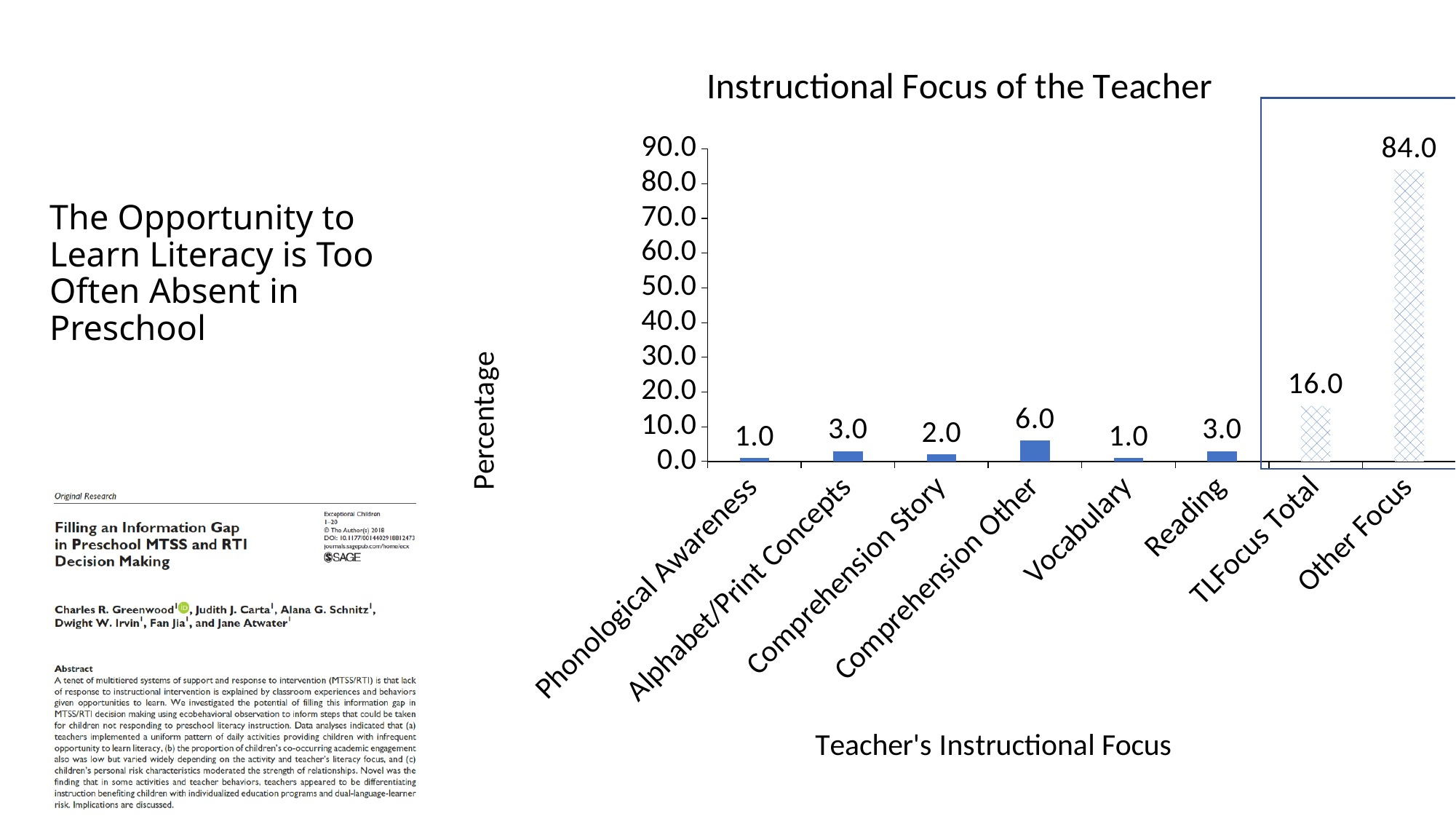
What is the value for Alphabet/Print Concepts? 3.0 Which category has the highest value? Other Focus What is the difference between Comprehension Other and Comprehension Story? 4.0 Which is larger, Reading or Vocabulary? Reading How many categories are shown on the x axis? 8 What is the value for Comprehension Other? 6.0 What is the value for TLFocus Total? 16.0 What is the title of the chart? Instructional Focus of the Teacher What is the value for Other Focus? 84.0 What kind of chart is shown? Bar chart Is the value for Other Focus greater or less than 80.0? greater What is the difference between Other Focus and TLFocus Total? 68.0